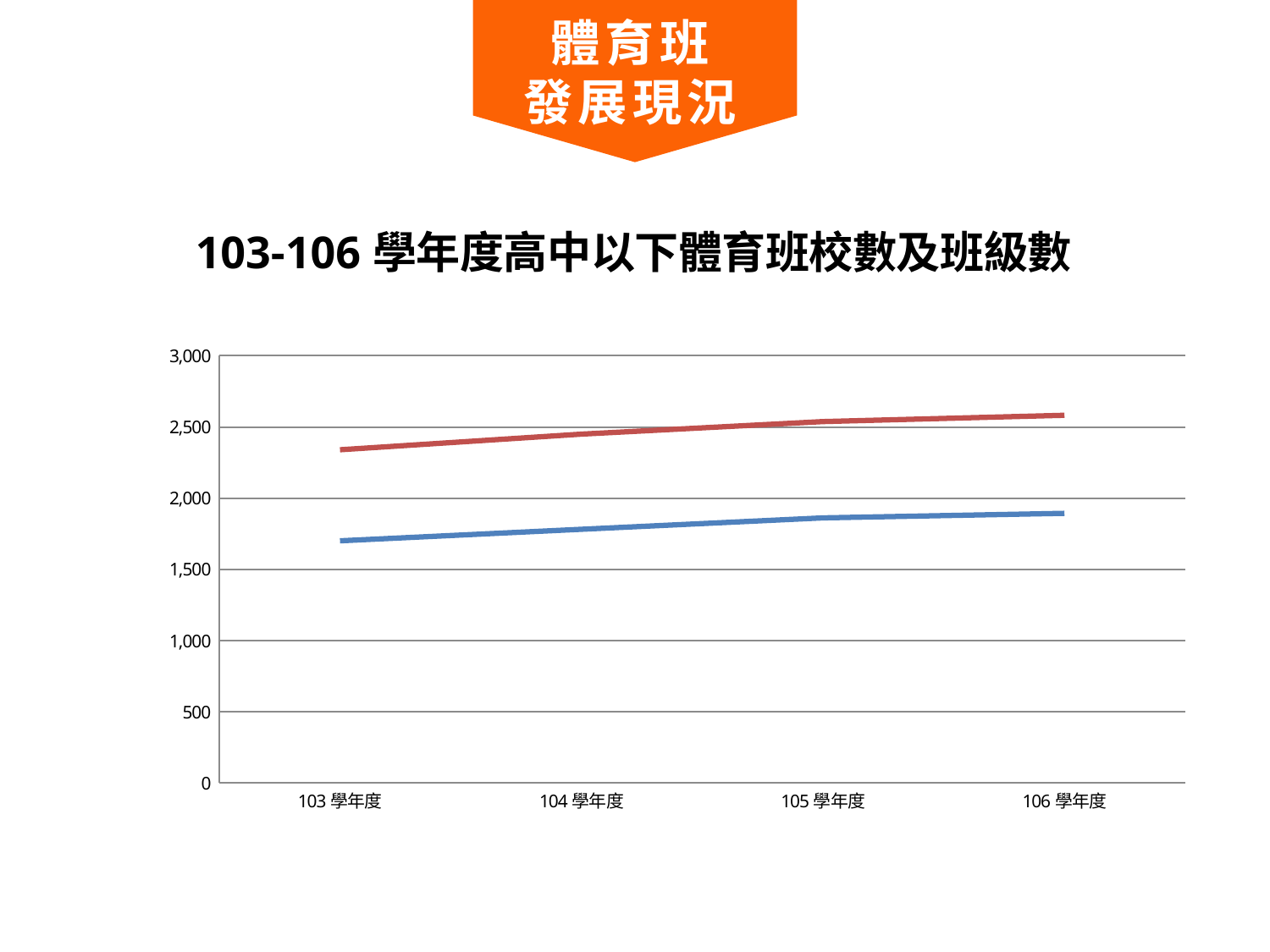
How many school years (categories) are shown on the x axis of the chart? 4 Which school year has the highest value on the blue line? 106 學年度 How many lines are plotted on the chart? 2 What kind of chart is shown on the slide? line chart Is the value of the blue line at 106 學年度 greater or less than 2,000? less Is the value of the red line at 106 學年度 greater or less than 2,500? greater At 106 學年度, which line has the higher value, the red line or the blue line? the red line What is the title of the chart on the slide? 103-106 學年度高中以下體育班校數及班級數 Is the value of the blue line at 103 學年度 greater or less than 1,500? greater Does the red line rise or fall from 103 學年度 to 106 學年度? rise Does the blue line rise or fall from 103 學年度 to 106 學年度? rise